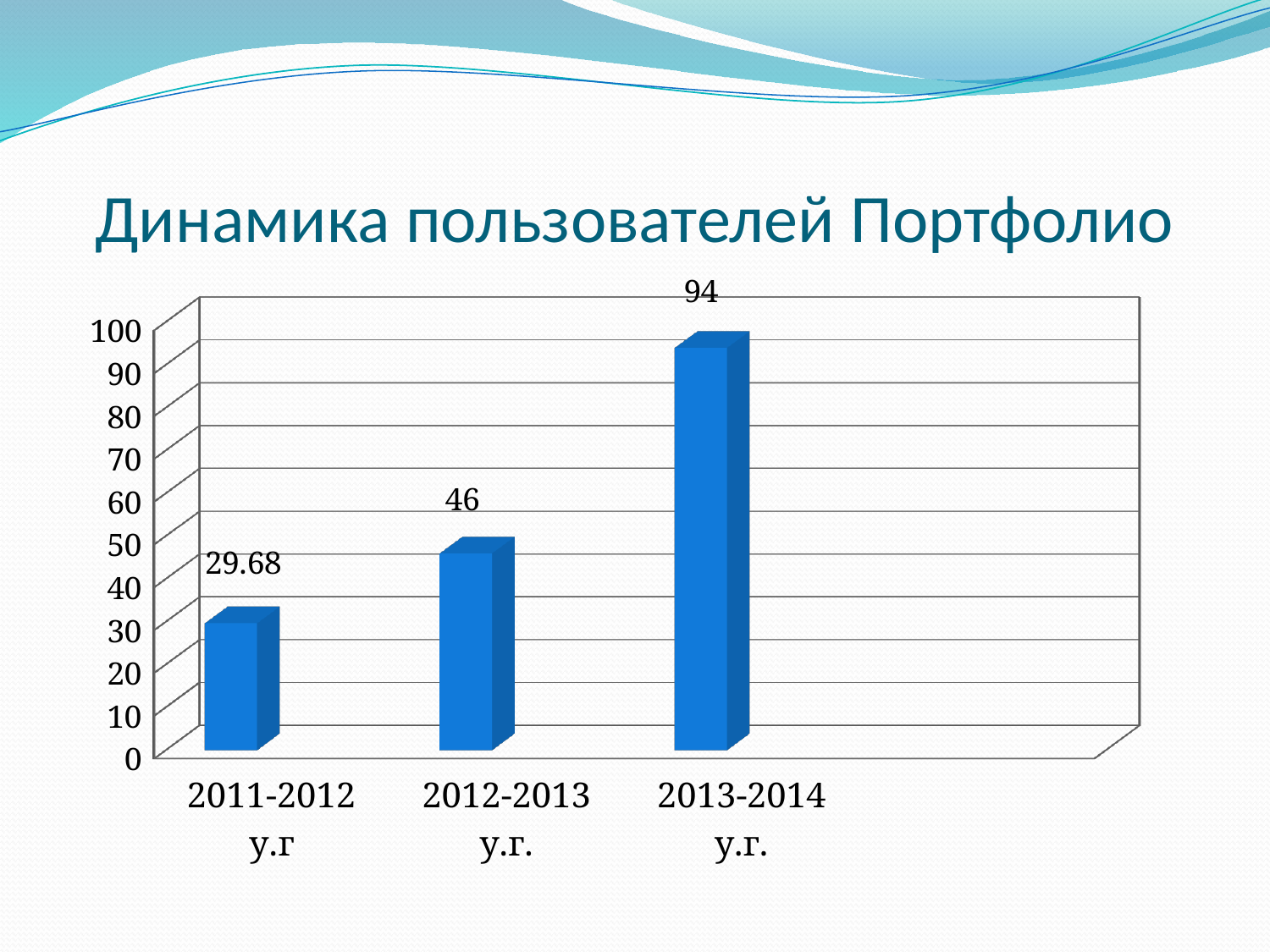
Which is larger, the value for 2012-2013 у.г. or the value for 2011-2012 у.г? 2012-2013 у.г. Which category has the highest value? 2013-2014 у.г. What kind of chart is shown on the slide? bar chart What is the value for 2013-2014 у.г.? 94 Is the value for 2013-2014 у.г. greater or less than 90? greater What is the value for 2012-2013 у.г.? 46 What is the value for 2011-2012 у.г? 29.68 Do the values rise or fall from 2011-2012 to 2013-2014? rise How many categories are shown on the x axis? 3 What is the difference between the values for 2013-2014 у.г. and 2012-2013 у.г.? 48 What is the difference between the values for 2012-2013 у.г. and 2011-2012 у.г? 16.32 Which category has the lowest value? 2011-2012 у.г